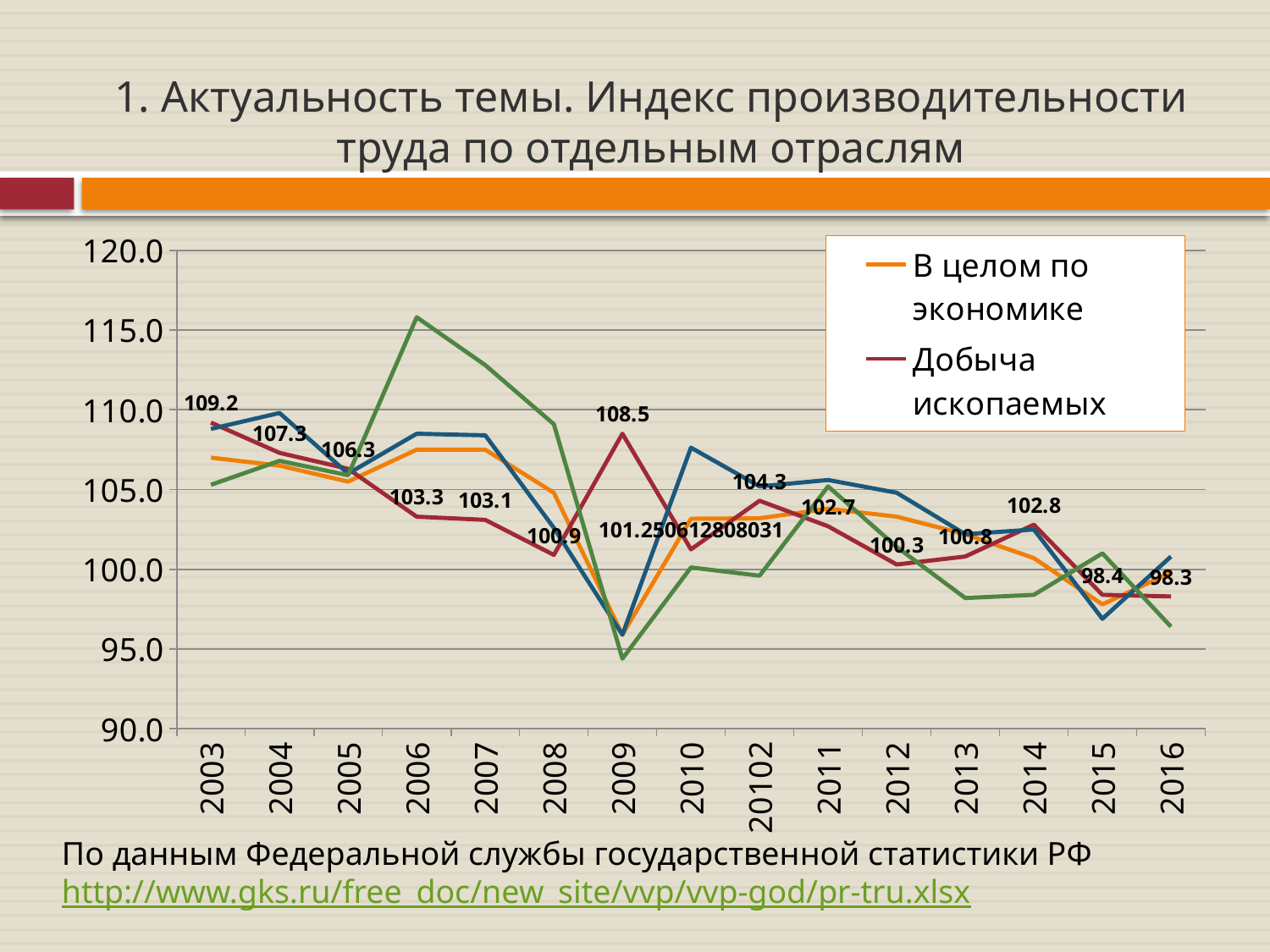
What is the value for Добыча ископаемых in 2003? 109.2 In which year does the Добыча ископаемых series have its lowest labelled value? 2016 Which year has the larger Добыча ископаемых value, 2008 or 2009? 2009 What is the value for Добыча ископаемых in 2016? 98.3 What is the difference between the Добыча ископаемых values for 2003 and 2016? 10.9 In which year does the Добыча ископаемых series reach its highest labelled value? 2003 What is the value for Добыча ископаемых in 2009? 108.5 Overall, does the Добыча ископаемых series rise or fall from 2003 to 2016? fall What kind of chart is shown on the slide? line chart Is the value for В целом по экономике in 2003 greater or less than 105? greater How many categories are shown on the x axis? 15 What is the difference between the Добыча ископаемых values for 2014 and 2015? 4.4